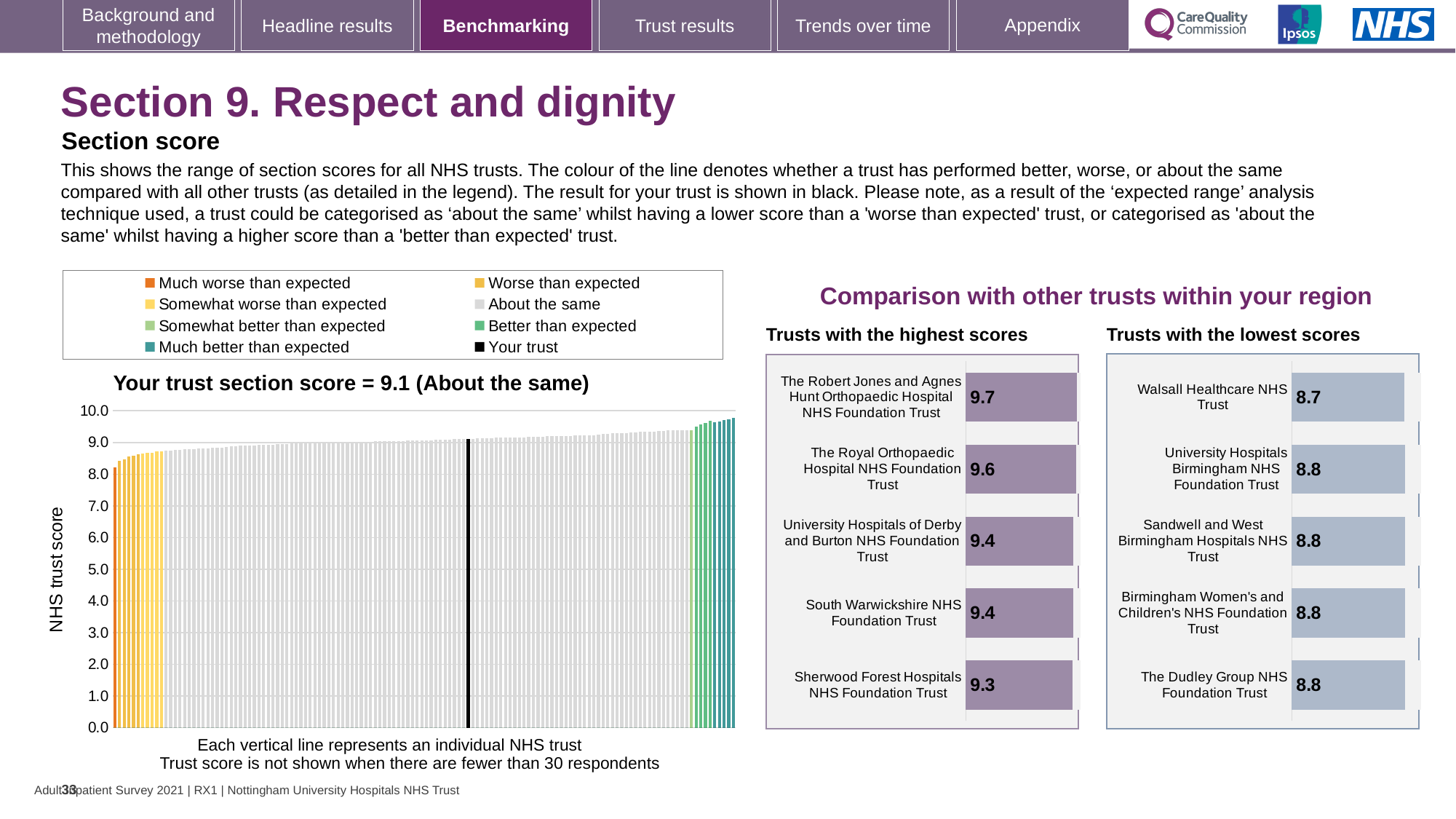
On the 'Your trust section score' chart, what is the section score for your trust? 9.1 On the 'Your trust section score' chart, what is the label of the y axis? NHS trust score On the 'Your trust section score' chart, do the trust scores rise or fall from left to right along the x axis? Rise On the 'Your trust section score' chart, is the value of the highest bar greater or less than 10.0? less On the 'Trusts with the lowest scores' chart, what is the score for The Dudley Group NHS Foundation Trust? 8.8 How many entries does the legend above the 'Your trust section score' chart list? 8 On the 'Trusts with the lowest scores' chart, how many trusts are shown? 5 On the 'Trusts with the lowest scores' chart, which trust has the lowest score? Walsall Healthcare NHS Trust On the 'Your trust section score' chart, what kind of chart is shown? Bar chart On the 'Trusts with the highest scores' chart, what is the score for The Royal Orthopaedic Hospital NHS Foundation Trust? 9.6 On the 'Trusts with the highest scores' chart, which trust has the highest score? The Robert Jones and Agnes Hunt Orthopaedic Hospital NHS Foundation Trust On the 'Trusts with the highest scores' chart, what is the difference between the scores of The Robert Jones and Agnes Hunt Orthopaedic Hospital NHS Foundation Trust and Sherwood Forest Hospitals NHS Foundation Trust? 0.4